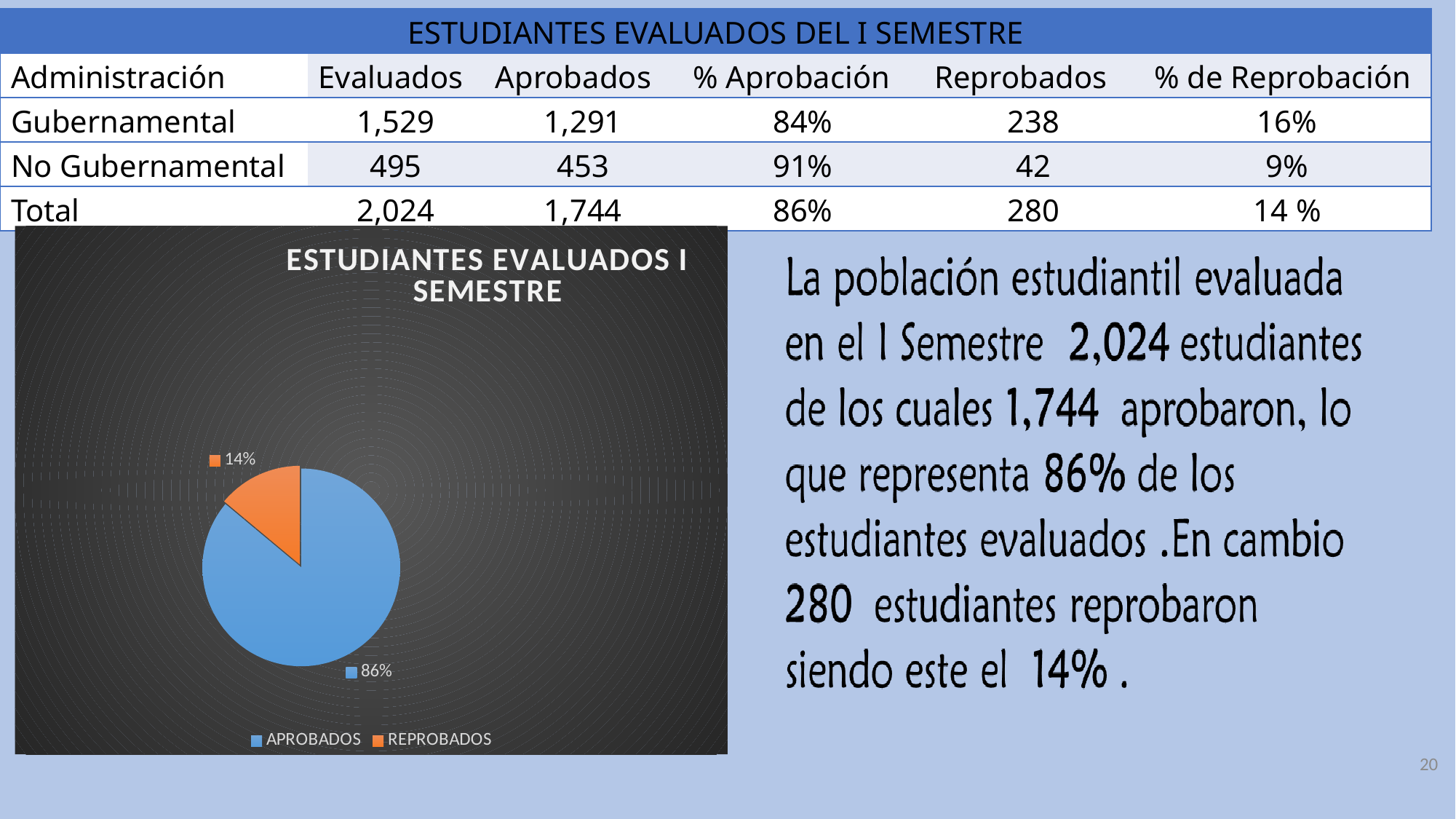
What is the title of the chart? ESTUDIANTES EVALUADOS I SEMESTRE Which slice of the pie is the largest? APROBADOS Which slice of the pie is the smallest? REPROBADOS What share of the pie does REPROBADOS represent? 14% Which is larger, the APROBADOS slice or the REPROBADOS slice? APROBADOS What is the difference in percentage points between the APROBADOS and REPROBADOS slices? 72% How many entries does the chart legend list? 2 How many slices does the pie chart have? 2 What kind of chart is shown on the slide? pie chart What share of the pie does APROBADOS represent? 86% What colour is the APROBADOS slice in the pie chart? blue